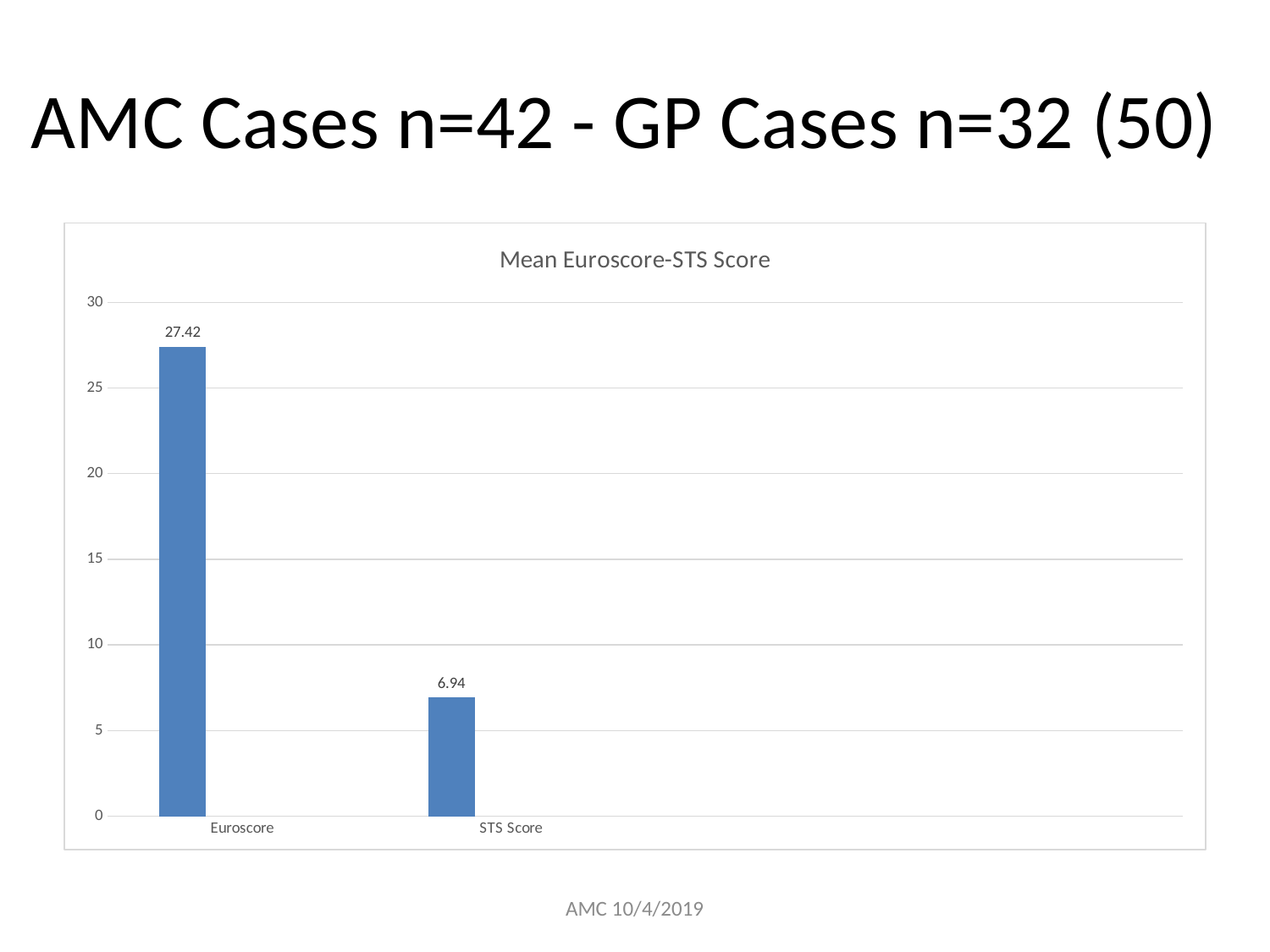
What is the value for Euroscore? 27.42 What is the highest value shown on the y axis? 30 Is the value for STS Score greater or less than 10? less What kind of chart is shown on the slide? bar chart Which category has the highest value? Euroscore Which category has the lowest value? STS Score What is the title of the chart? Mean Euroscore-STS Score Which is larger, the value for Euroscore or the value for STS Score? Euroscore How many categories are shown on the x axis? 2 Is the value for Euroscore greater or less than 25? greater What is the difference between the Euroscore and STS Score values? 20.48 What is the value for STS Score? 6.94